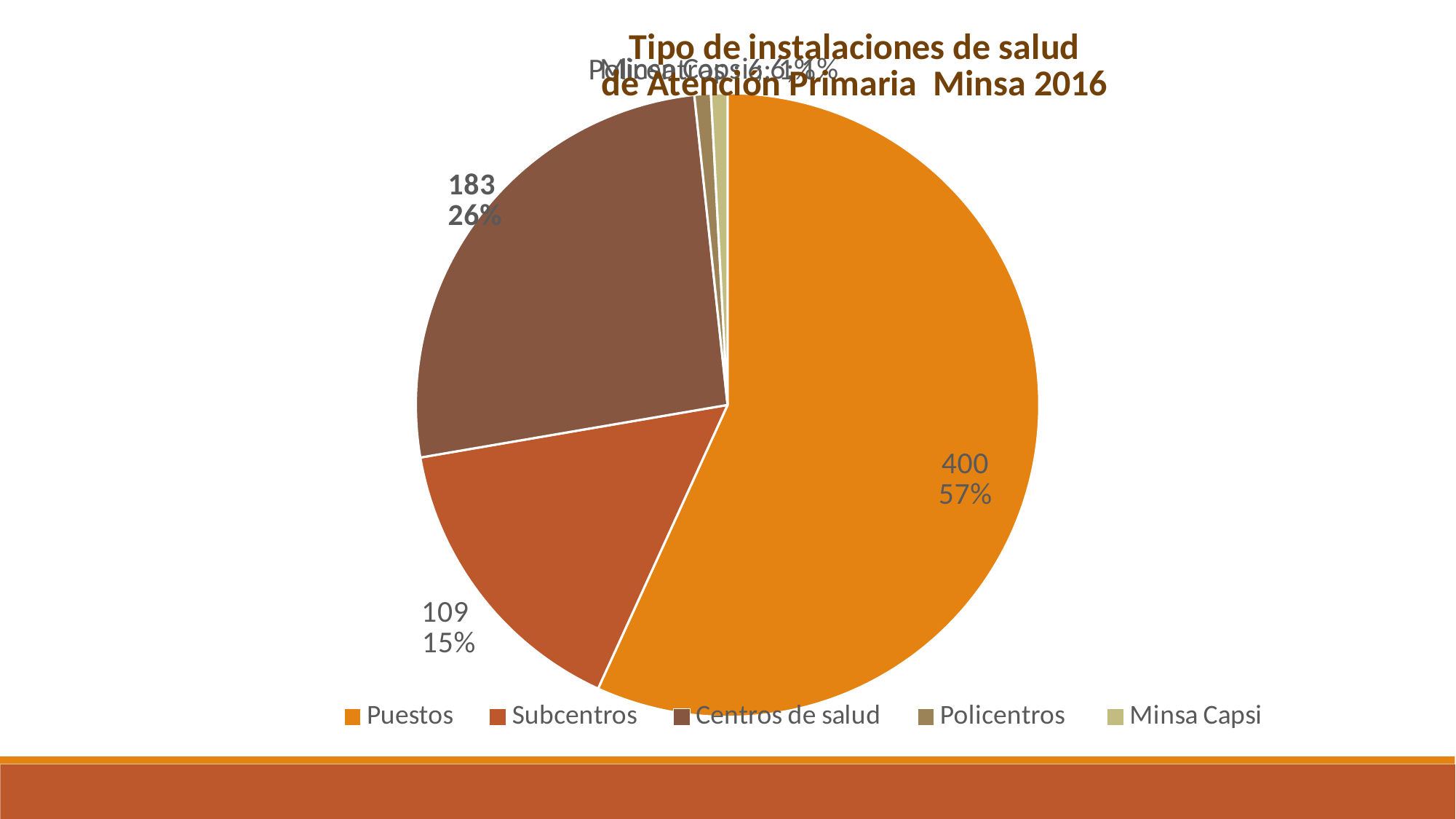
What is the difference between the values for Puestos and Centros de salud? 217 What share of the pie does Puestos represent? 57% What share of the pie does Subcentros represent? 15% How many categories does the legend list? 5 What kind of chart is shown on the slide? pie chart What share of the pie does Centros de salud represent? 26% What is the value for Puestos? 400 What is the value for Centros de salud? 183 Which is larger, Centros de salud or Subcentros? Centros de salud Which category has the largest slice? Puestos What is the value for Subcentros? 109 What is the title of the chart? Tipo de instalaciones de salud de Atención Primaria Minsa 2016